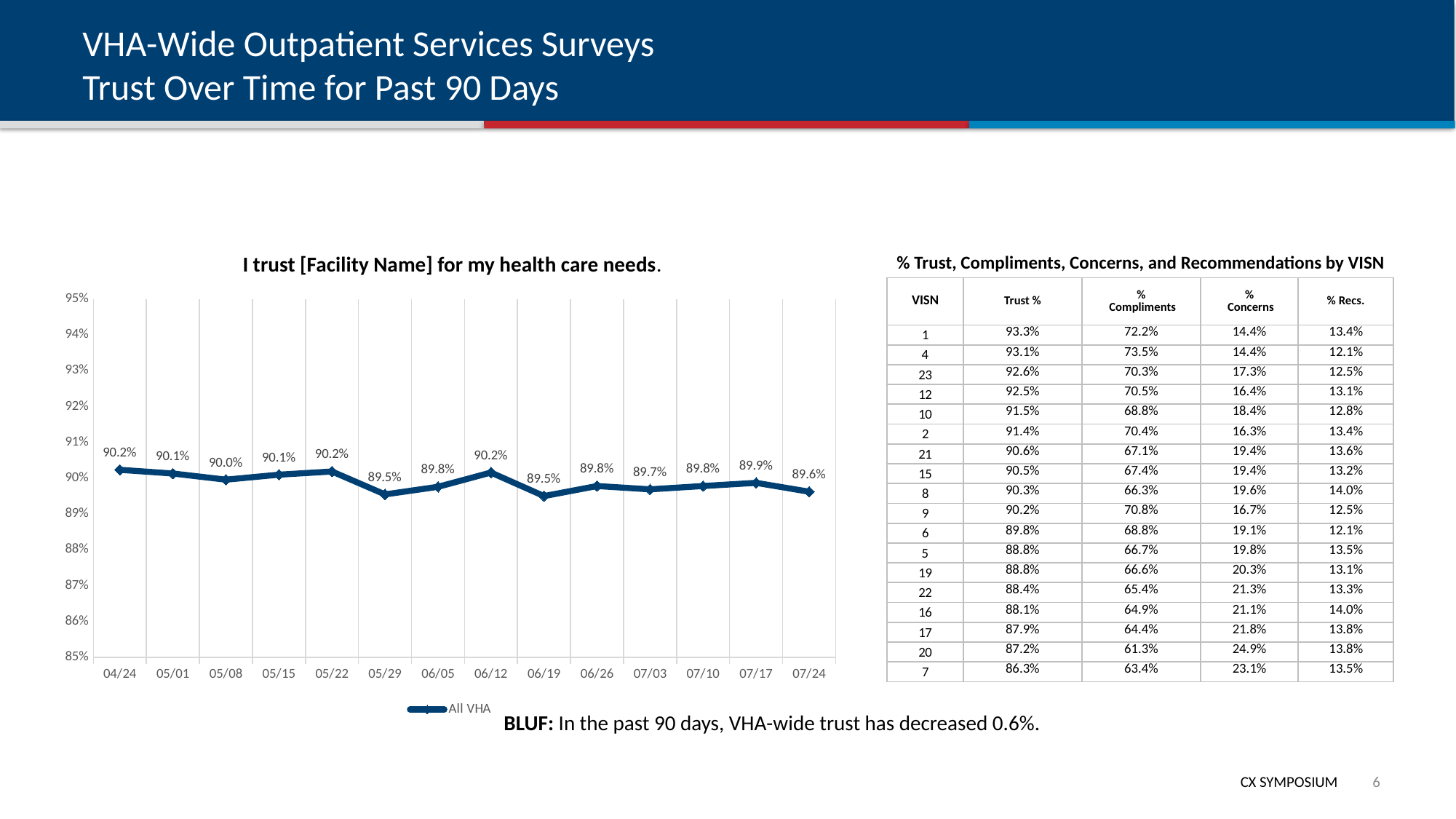
What is the trust value for 04/24? 90.2% What kind of chart is shown on the slide? line chart Does the trust value overall rise or fall from 04/24 to 07/24? fall How many dates are plotted on the chart? 14 What is the trust value for 07/17? 89.9% What is the trust value for 07/24? 89.6% What is the trust value for 05/29? 89.5% Which date has the higher trust value, 05/22 or 05/29? 05/22 What is the lowest trust value plotted on the chart? 89.5% What is the difference between the trust value on 04/24 and on 07/24? 0.6% How many series does the chart legend list? 1 What is the highest trust value plotted on the chart? 90.2%